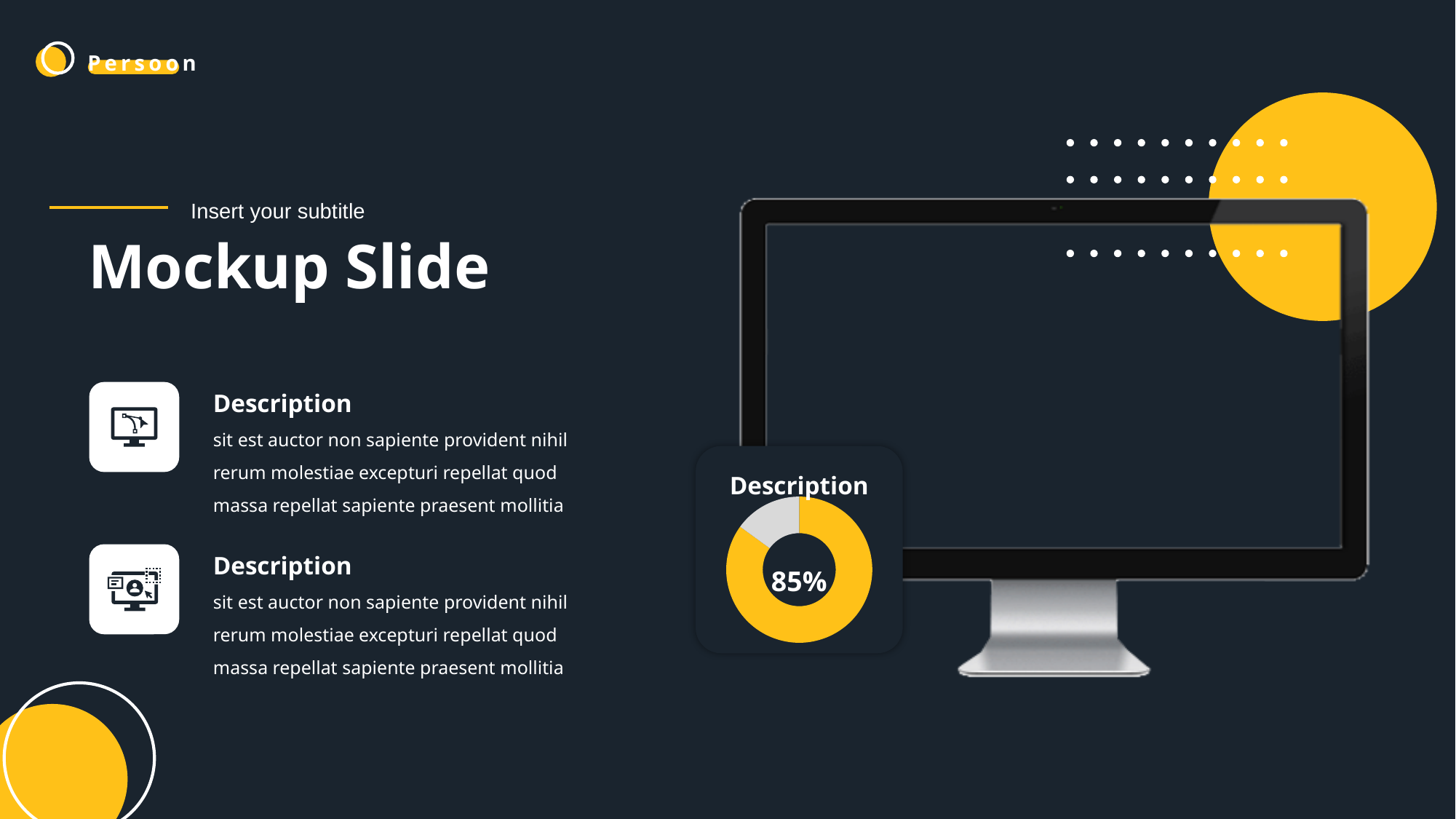
What share of the donut chart does the yellow slice represent? 85% Is the yellow slice of the donut chart greater or less than 50% of the whole? greater Which slice of the donut chart is larger, the yellow one or the grey one? Yellow What percentage is printed in the centre of the donut chart? 85% What colour is the largest slice of the donut chart? Yellow What is the title shown above the donut chart? Description What kind of chart is shown on the slide? Donut chart How many slices does the donut chart have? 2 Is the grey slice of the donut chart greater or less than 50% of the whole? less